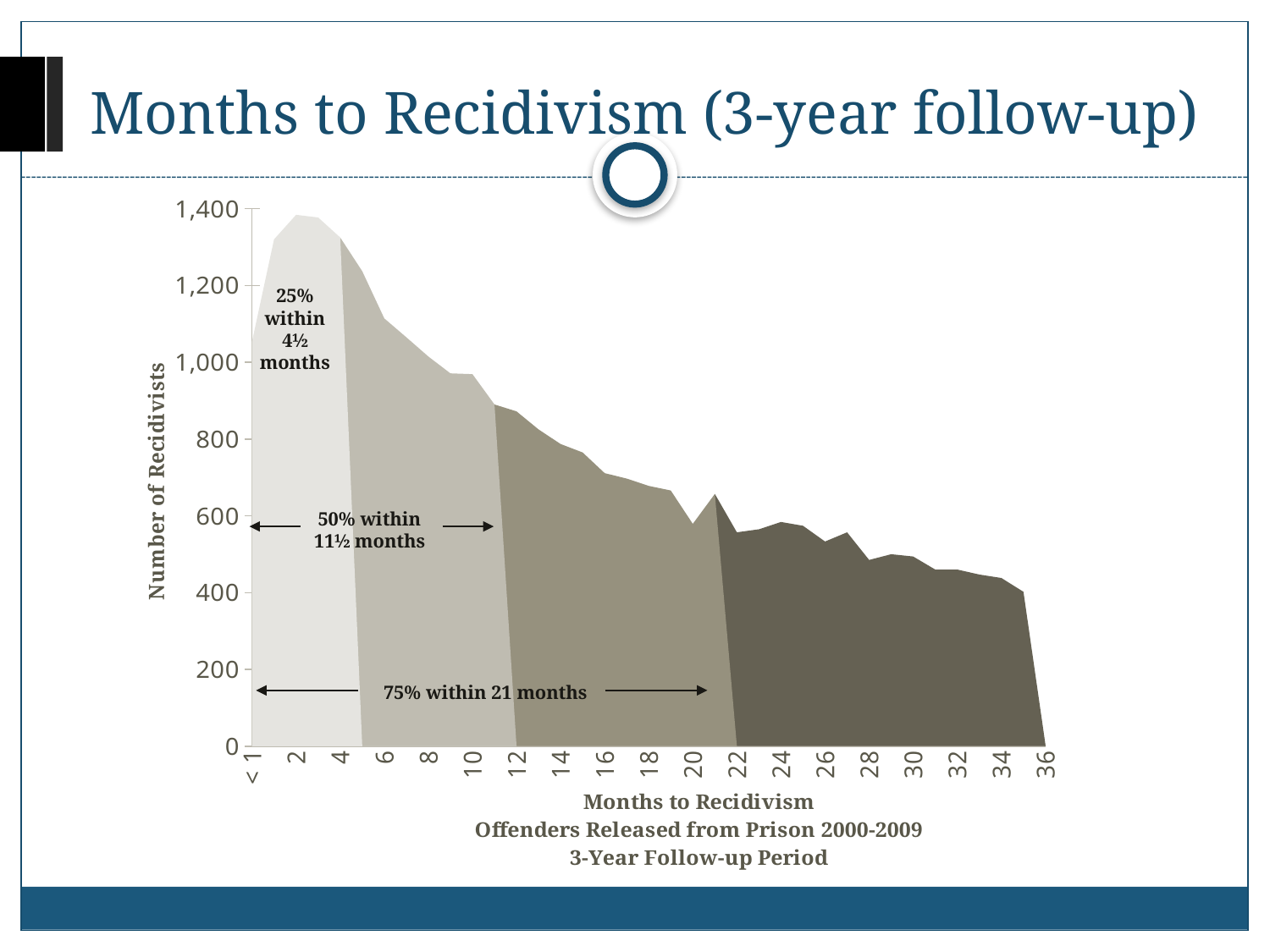
What kind of chart is shown on the slide? Area chart According to the annotation on the chart, within how many months did 50% of offenders recidivate? 11½ months What is the title of the horizontal axis? Months to Recidivism Is the number of recidivists at month 2 greater or less than 1,200? greater Is the number of recidivists at month 24 greater or less than 400? greater Is the number of recidivists at month 12 greater or less than 1,000? less What is the title of the vertical axis? Number of Recidivists According to the annotation on the chart, within how many months did 75% of offenders recidivate? 21 months According to the annotation on the chart, within how many months did 25% of offenders recidivate? 4½ months Which is larger, the number of recidivists at month 6 or at month 20? Month 6 Do the values generally rise or fall as months to recidivism increase from month 4 to month 34? Fall